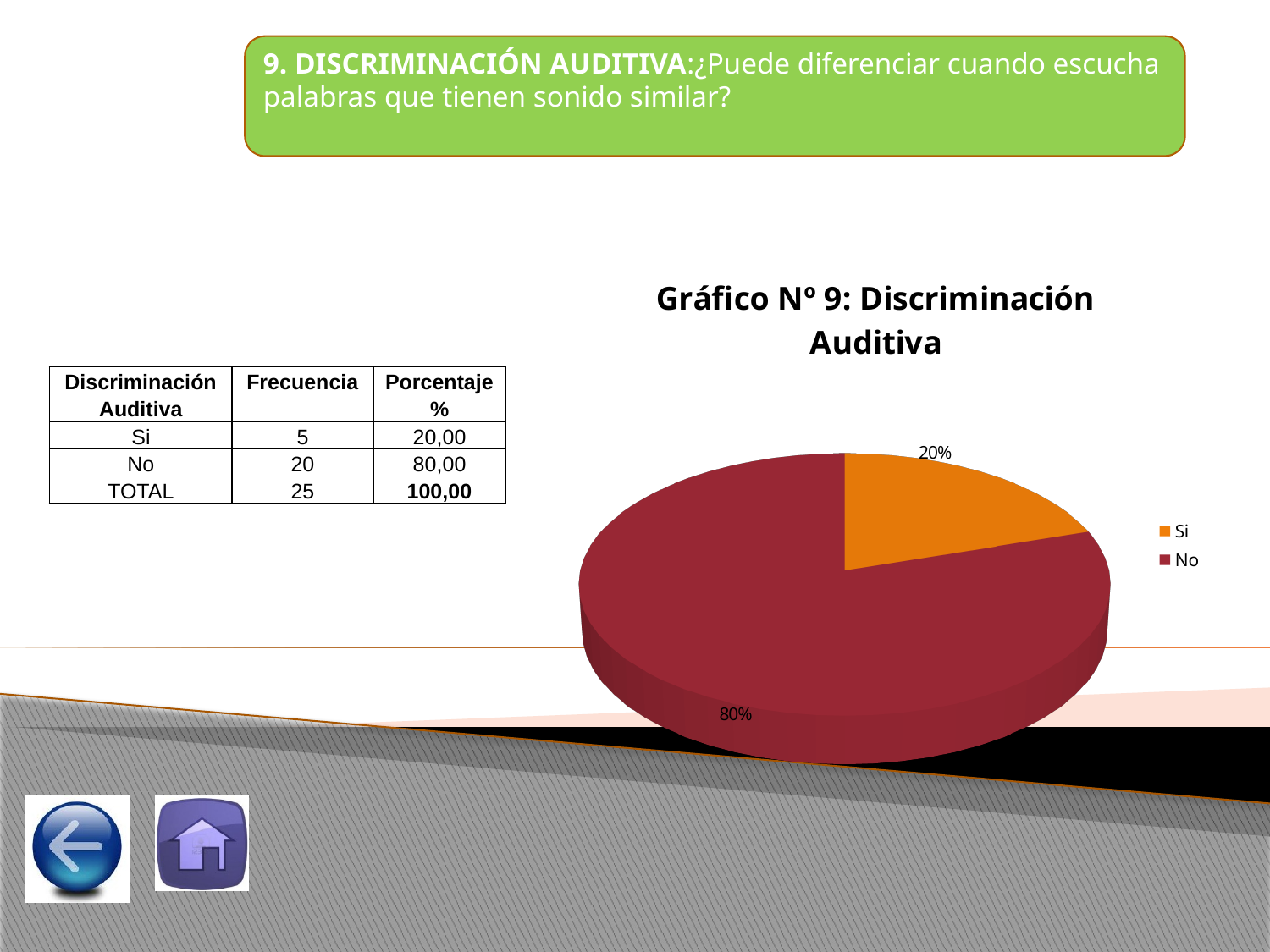
Which slice is the smallest in the pie chart? Si What percentage does the 'No' slice show? 80% What kind of chart is shown on the slide? pie chart What colour is the 'Si' slice in the pie chart? orange How many entries does the legend list? 2 What share of the pie does the 'No' slice represent? 80% Which is larger, the 'Si' slice or the 'No' slice? No Which slice is the largest in the pie chart? No What percentage does the 'Si' slice show? 20% What is the title of the chart? Gráfico Nº 9: Discriminación Auditiva What is the difference in percentage points between the 'No' slice and the 'Si' slice? 60 How many slices does the pie chart have? 2